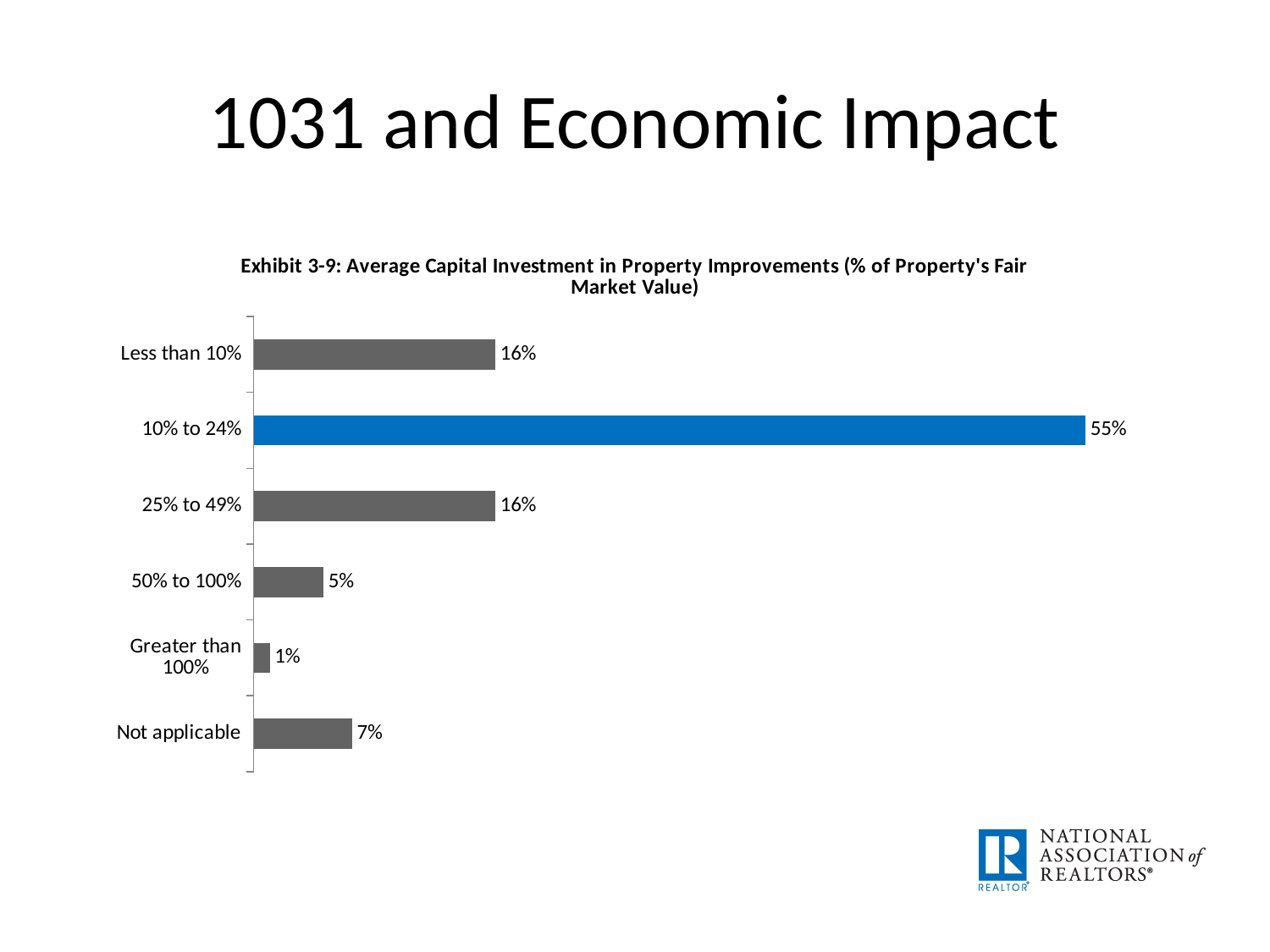
Which category has the lowest value? Greater than 100% How many categories are shown in the chart? 6 What is the value for the "Less than 10%" category? 16% Which is larger, the value for "Not applicable" or the value for "50% to 100%"? Not applicable What is the value for the "10% to 24%" category? 55% Which category has the highest value? 10% to 24% What is the value for the "50% to 100%" category? 5% Which category's bar is coloured blue rather than grey? 10% to 24% What is the title of the chart? Exhibit 3-9: Average Capital Investment in Property Improvements (% of Property's Fair Market Value) What is the difference between the values for "10% to 24%" and "25% to 49%"? 39% What kind of chart is shown on the slide? Bar chart What is the value for the "Not applicable" category? 7%